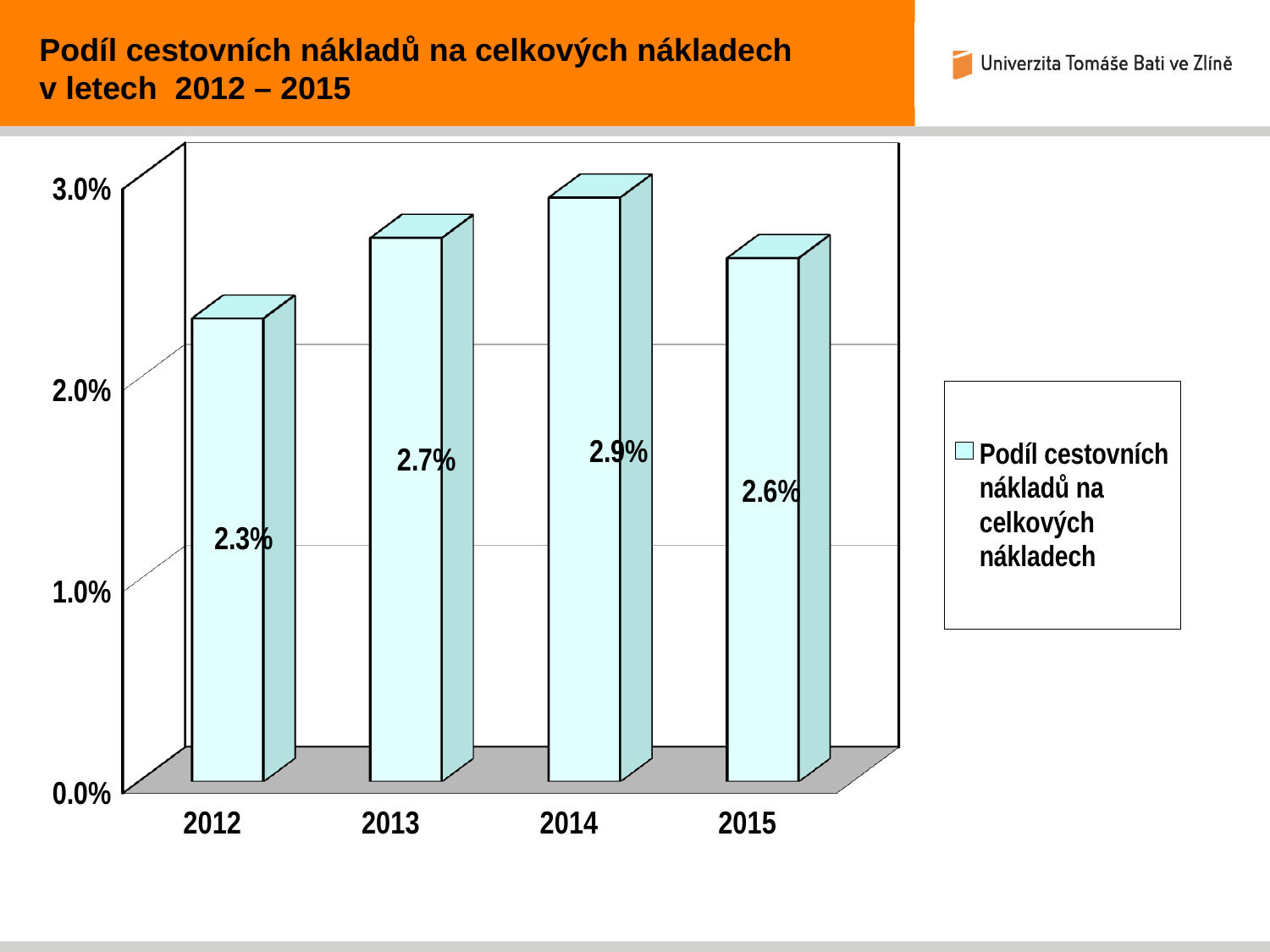
What is the share of travel costs in total costs for 2014? 2.9% Which year has a larger value, 2013 or 2015? 2013 What is the value shown for 2015? 2.6% What is the difference between the values for 2014 and 2012? 0.6% Is the value for 2013 greater or less than 2.0%? greater What is the share of travel costs in total costs for 2012? 2.3% What kind of chart is shown on the slide? bar chart Which year has the lowest share of travel costs in total costs? 2012 How many years are shown on the x axis? 4 How many series does the legend list? 1 Which year has the highest share of travel costs in total costs? 2014 What is the legend entry for the plotted series? Podíl cestovních nákladů na celkových nákladech